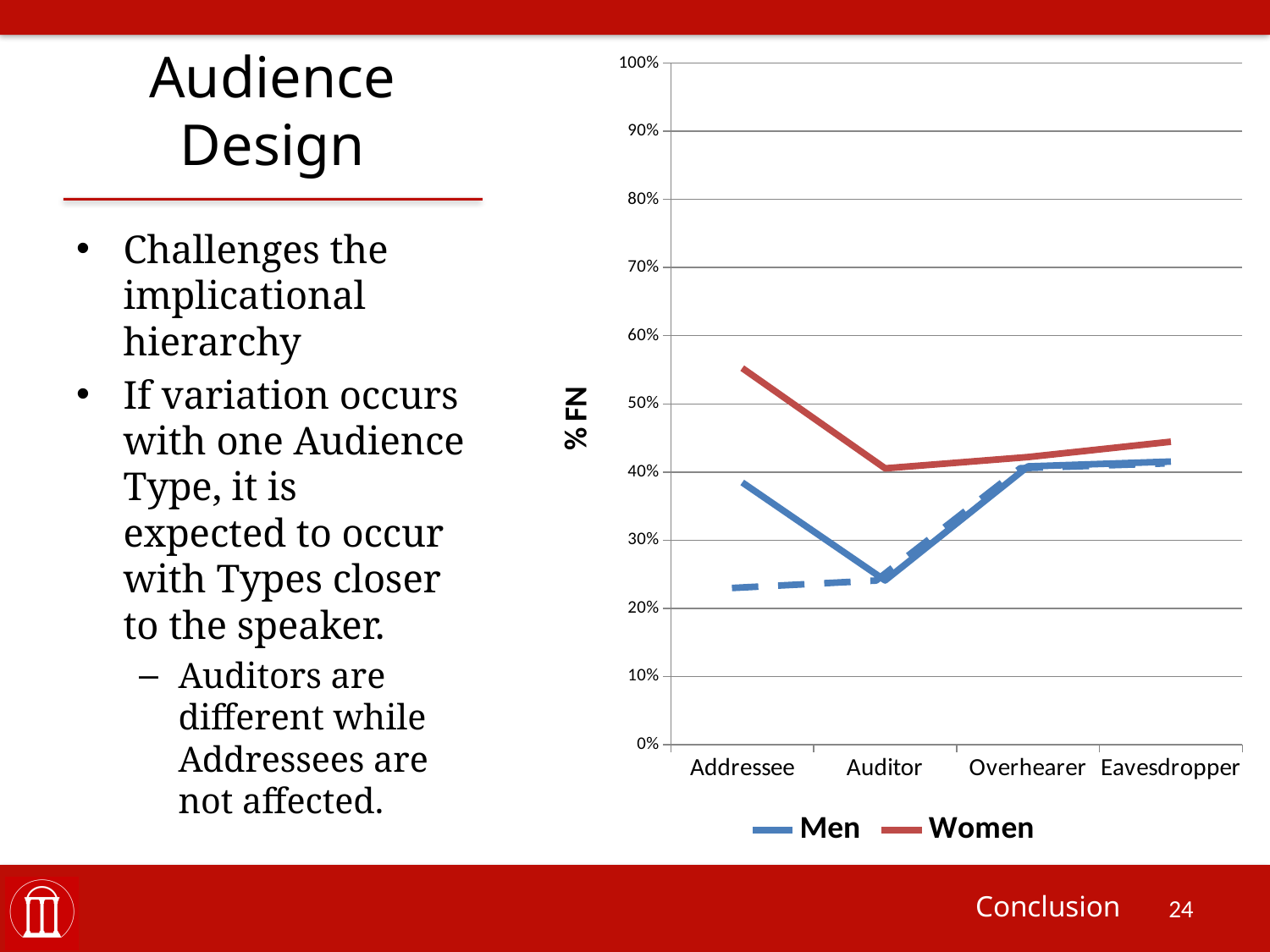
For which audience type is the Women series highest? Addressee For which audience type is the Women series lowest? Auditor How many audience-type categories are shown on the x axis? 4 Is the value for Men at Auditor greater or less than 30%? less At Addressee, which series has the larger value, Men or Women? Women Which colour represents the Women series in the legend? red Does the Women series rise or fall from Auditor to Eavesdropper? rise For which audience type is the Men series lowest? Auditor What is the title of the vertical axis? % FN What kind of chart is shown on the slide? line chart How many series does the chart legend list? 2 Is the value for Women at Addressee greater or less than 50%? greater